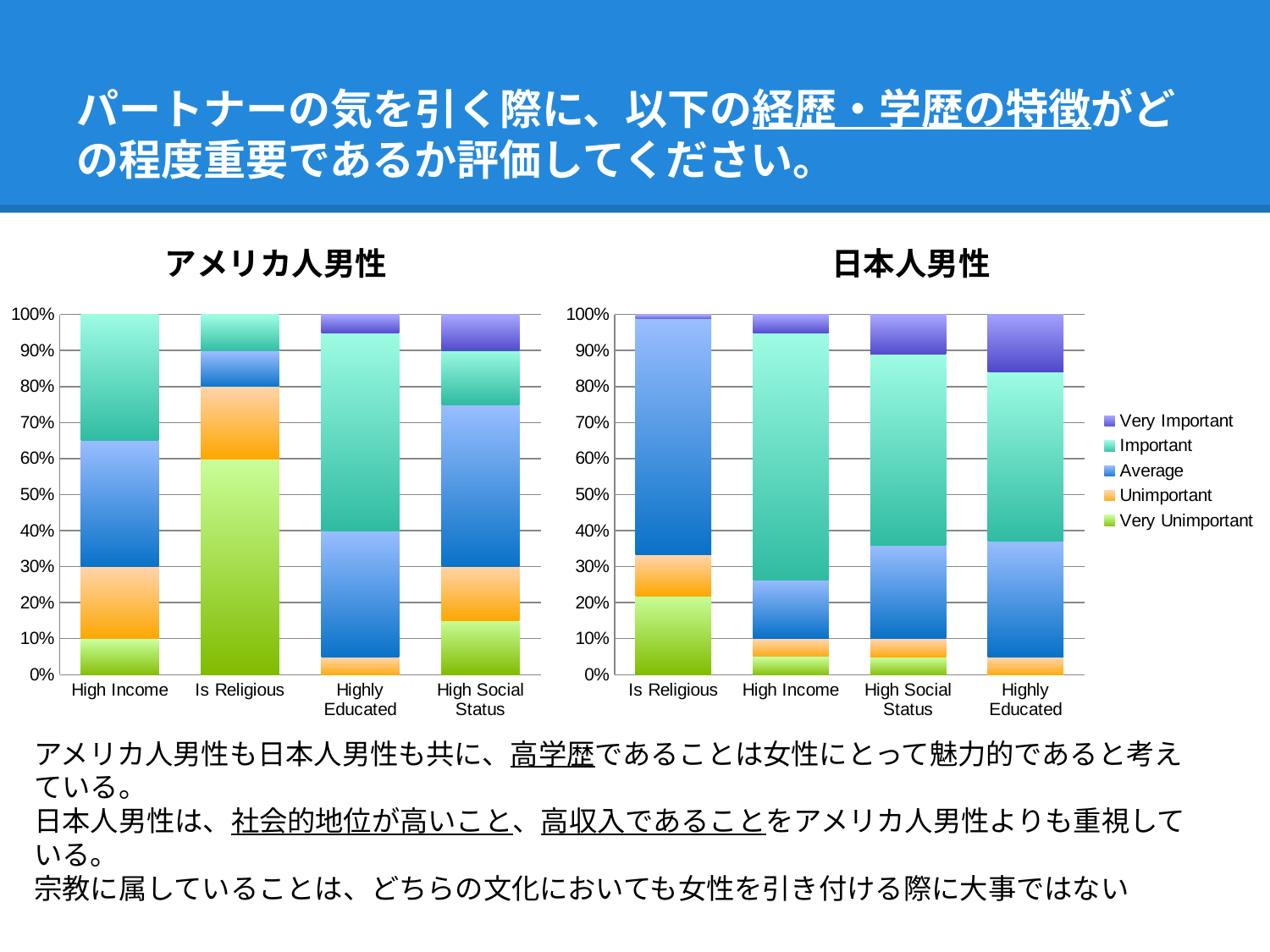
Which category appears first on the x axis of the 日本人男性 chart? Is Religious How many categories are shown on the x axis of the 日本人男性 chart? 4 In the アメリカ人男性 chart, is the Very Important segment larger for High Social Status or for Highly Educated? High Social Status In the 日本人男性 chart, is the Average segment larger for Is Religious or for High Income? Is Religious In the アメリカ人男性 chart, is the Very Unimportant value for Is Religious greater or less than 50%? greater In the アメリカ人男性 chart, is the Very Unimportant segment for Highly Educated greater or less than 10%? less In the 日本人男性 chart, which category has the largest Very Important segment? Highly Educated What kind of chart is the アメリカ人男性 chart? Stacked bar chart In the アメリカ人男性 chart, which category has the largest Very Unimportant segment? Is Religious Which legend entry is shown in green? Very Unimportant How many series does the legend list? 5 In the 日本人男性 chart, is the Important segment for High Income greater or less than 50%? greater